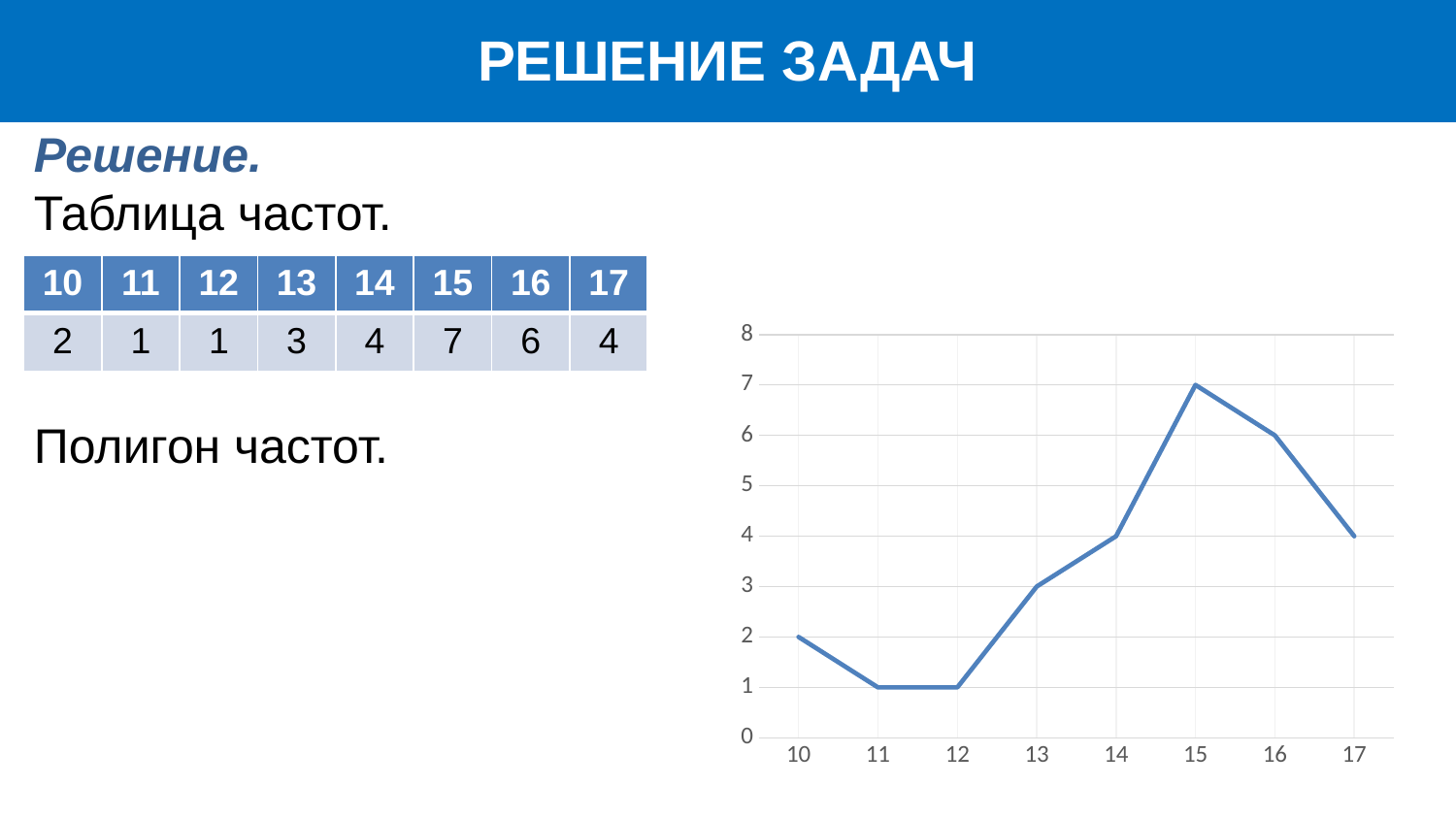
What is the lowest value plotted on the chart? 1 What is the value plotted for 15 on the chart? 7 What is the highest value shown on the vertical axis of the chart? 8 Do the values on the chart rise or fall from 12 to 15? rise Which has a larger value on the chart, 14 or 16? 16 What kind of chart is shown on the slide? line chart How many points are plotted on the chart? 8 Is the value for 16 on the chart greater or less than 5? greater What is the difference between the values for 15 and 17 on the chart? 3 What is the value plotted for 10 on the chart? 2 What is the value plotted for 13 on the chart? 3 Which x value has the highest point on the chart? 15